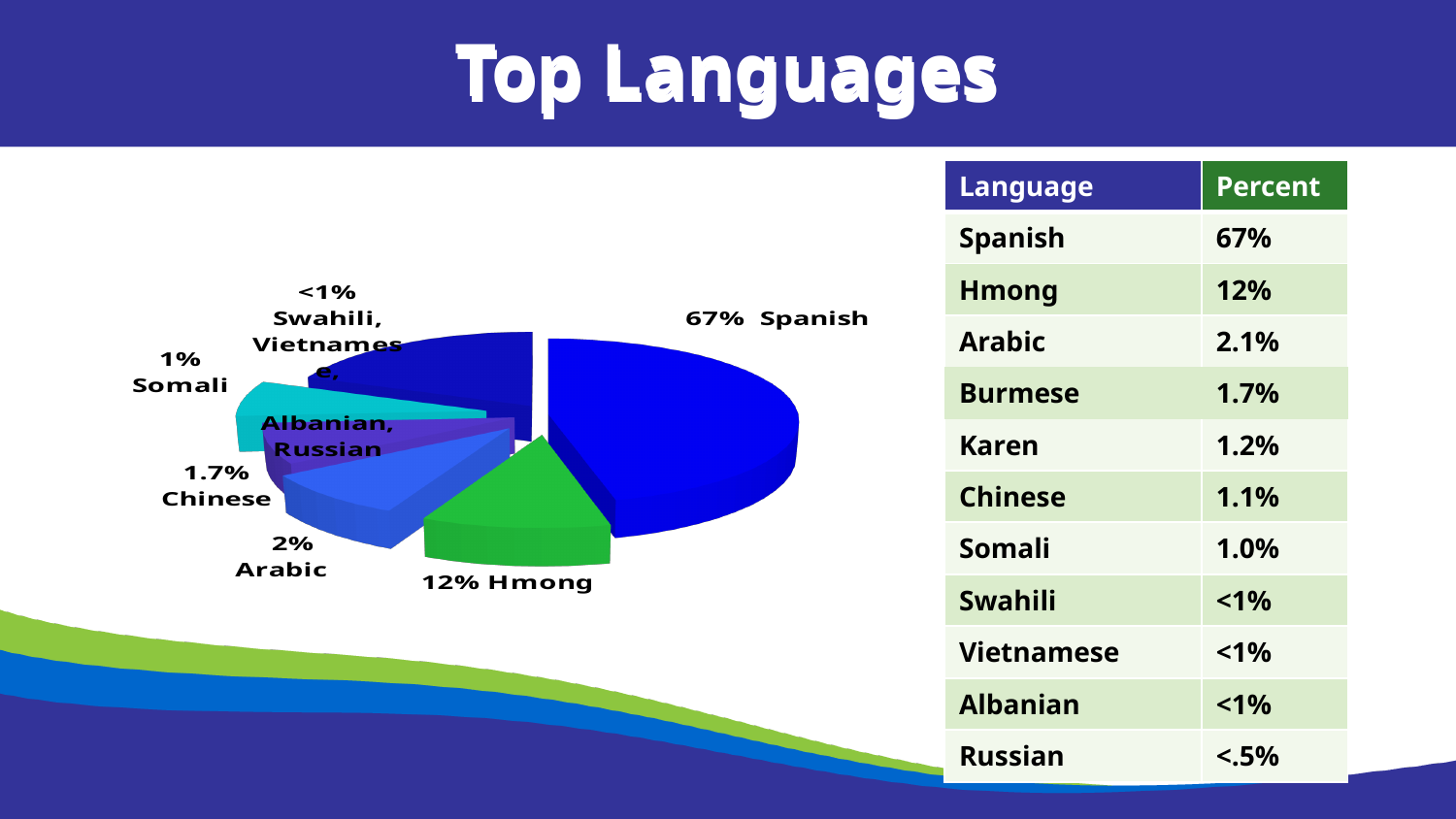
Which language has the largest slice in the pie chart? Spanish Which slice is larger in the pie chart, Hmong or Arabic? Hmong What kind of chart is shown on the slide? pie chart According to the pie chart's data label, what share of the pie does Hmong have? 12% What is the difference between the Spanish and Hmong percentages shown on the pie chart? 55% What is the combined percentage of the Spanish and Hmong slices shown on the pie chart? 79% What is the title of the slide containing the pie chart? Top Languages Which slice is larger in the pie chart, Spanish or Somali? Spanish According to the pie chart's data label, what percentage is shown for Somali? 1% According to the pie chart's data label, what share of the pie does Spanish have? 67% According to the pie chart's data label, what percentage is shown for Arabic? 2% Which languages are grouped together under the "<1%" label on the pie chart? Swahili, Vietnamese, Albanian, Russian